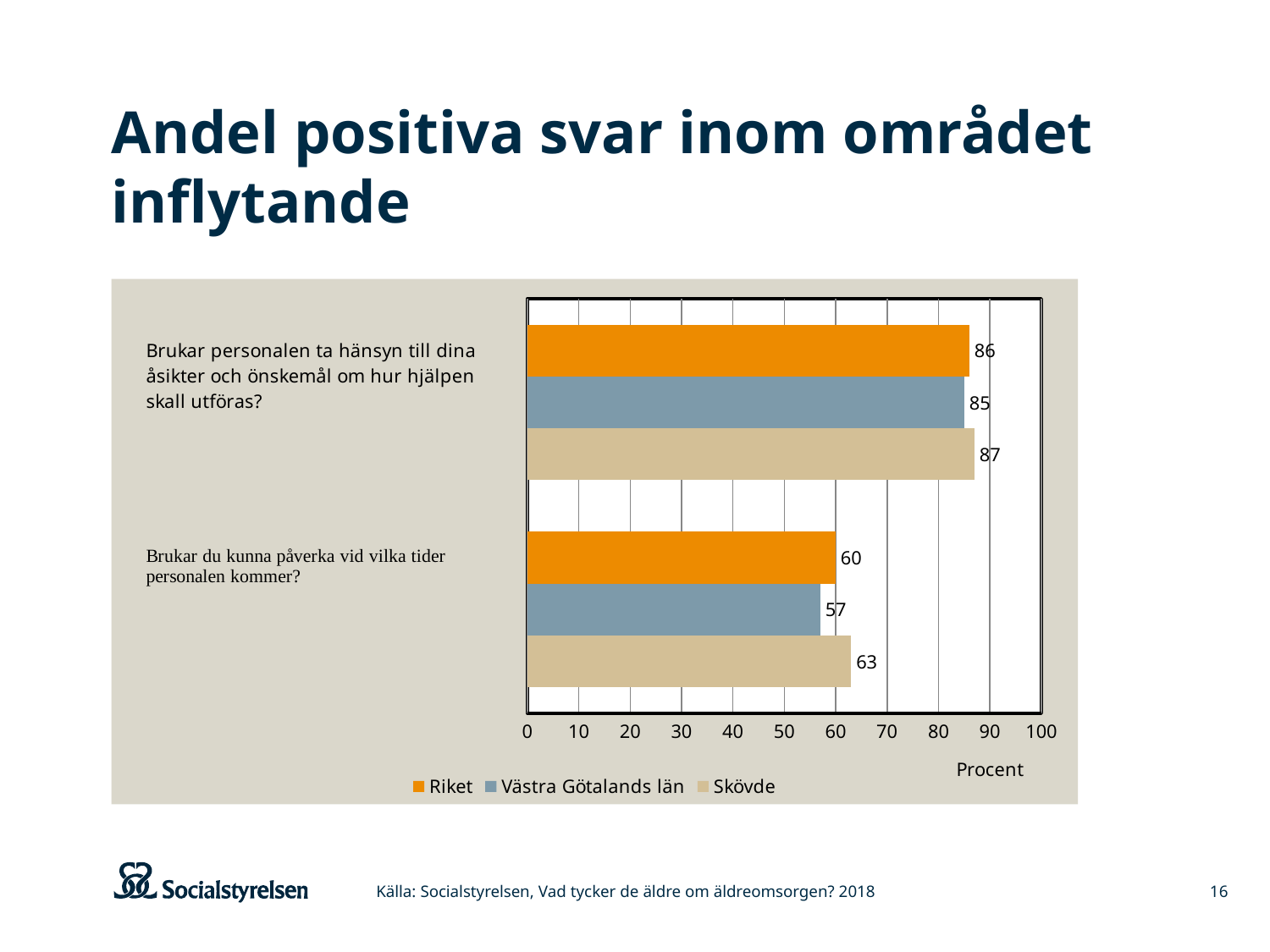
What is the difference between Skövde and Västra Götalands län on the question 'Brukar du kunna påverka vid vilka tider personalen kommer?' 6 How many series does the legend list? 3 Is the Riket value higher for 'Brukar personalen ta hänsyn till dina åsikter...' or for 'Brukar du kunna påverka vid vilka tider personalen kommer?' Brukar personalen ta hänsyn till dina åsikter och önskemål om hur hjälpen skall utföras? How many questions (categories) are shown on the chart? 2 What kind of chart is shown on the slide? Bar chart What unit label is shown on the x axis? Procent Which series has the lowest value on the question 'Brukar personalen ta hänsyn till dina åsikter och önskemål om hur hjälpen skall utföras?' Västra Götalands län What is the value for Riket on the question 'Brukar du kunna påverka vid vilka tider personalen kommer?' 60 Which series has the highest value on the question 'Brukar du kunna påverka vid vilka tider personalen kommer?' Skövde What is the value for Västra Götalands län on the question 'Brukar du kunna påverka vid vilka tider personalen kommer?' 57 What is the difference between the Riket values for the two questions? 26 What is the value for Skövde on the question 'Brukar personalen ta hänsyn till dina åsikter och önskemål om hur hjälpen skall utföras?' 87